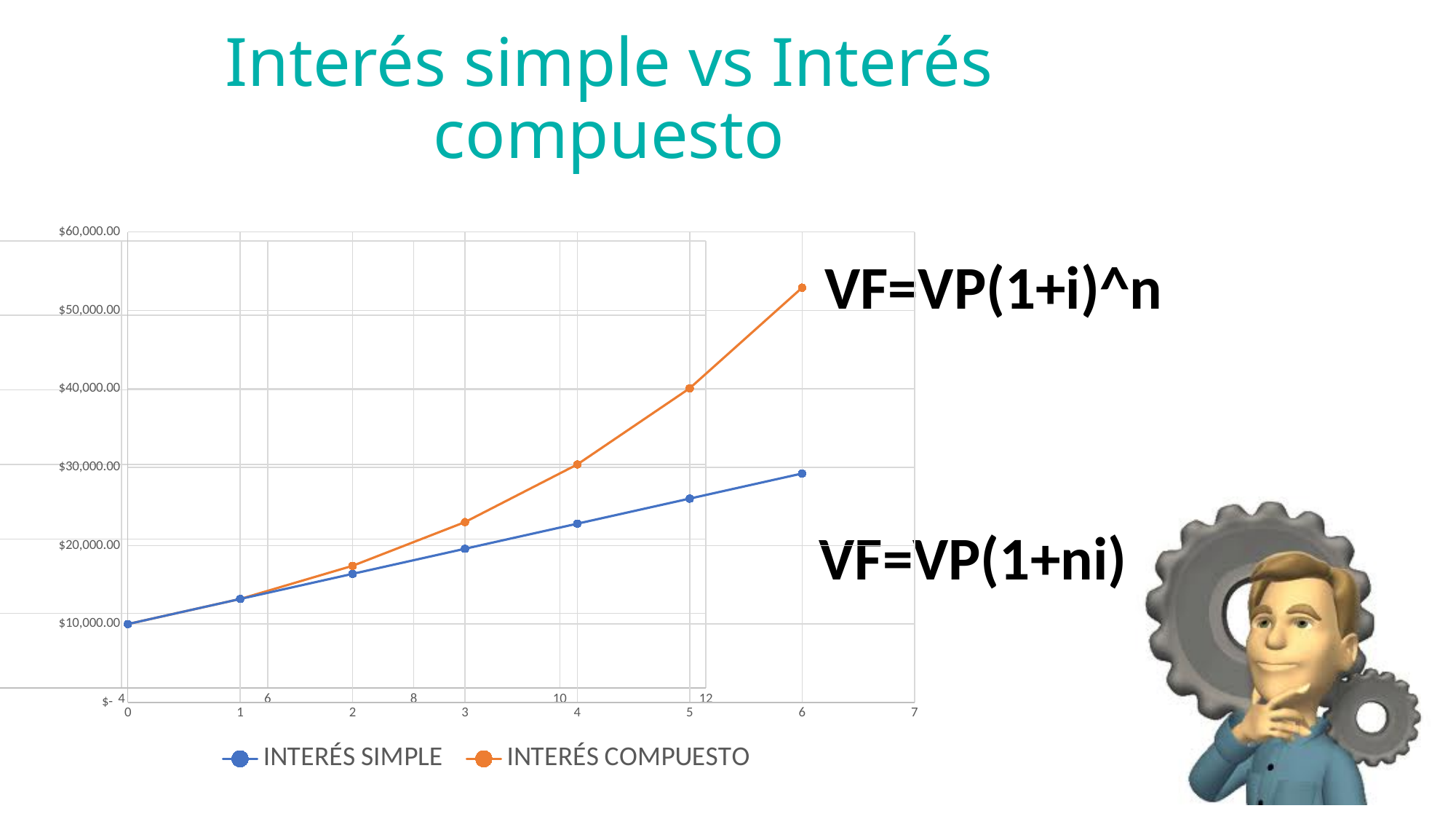
Which series reaches the highest value on the chart? INTERÉS COMPUESTO What is the value of both series at x = 0? $10,000.00 At x = 6, which series has the larger value, INTERÉS SIMPLE or INTERÉS COMPUESTO? INTERÉS COMPUESTO Is the value of INTERÉS SIMPLE at x = 6 greater or less than $30,000.00? less How many series does the legend list? 2 What colour is the INTERÉS SIMPLE line in the legend? blue How many data points are plotted for the INTERÉS COMPUESTO series? 7 Do the values of the INTERÉS COMPUESTO series rise or fall as the x axis increases? rise Is the value of INTERÉS COMPUESTO at x = 6 greater or less than $50,000.00? greater Is the value of INTERÉS COMPUESTO at x = 5 greater or less than $50,000.00? less What kind of chart is shown on the slide? line chart